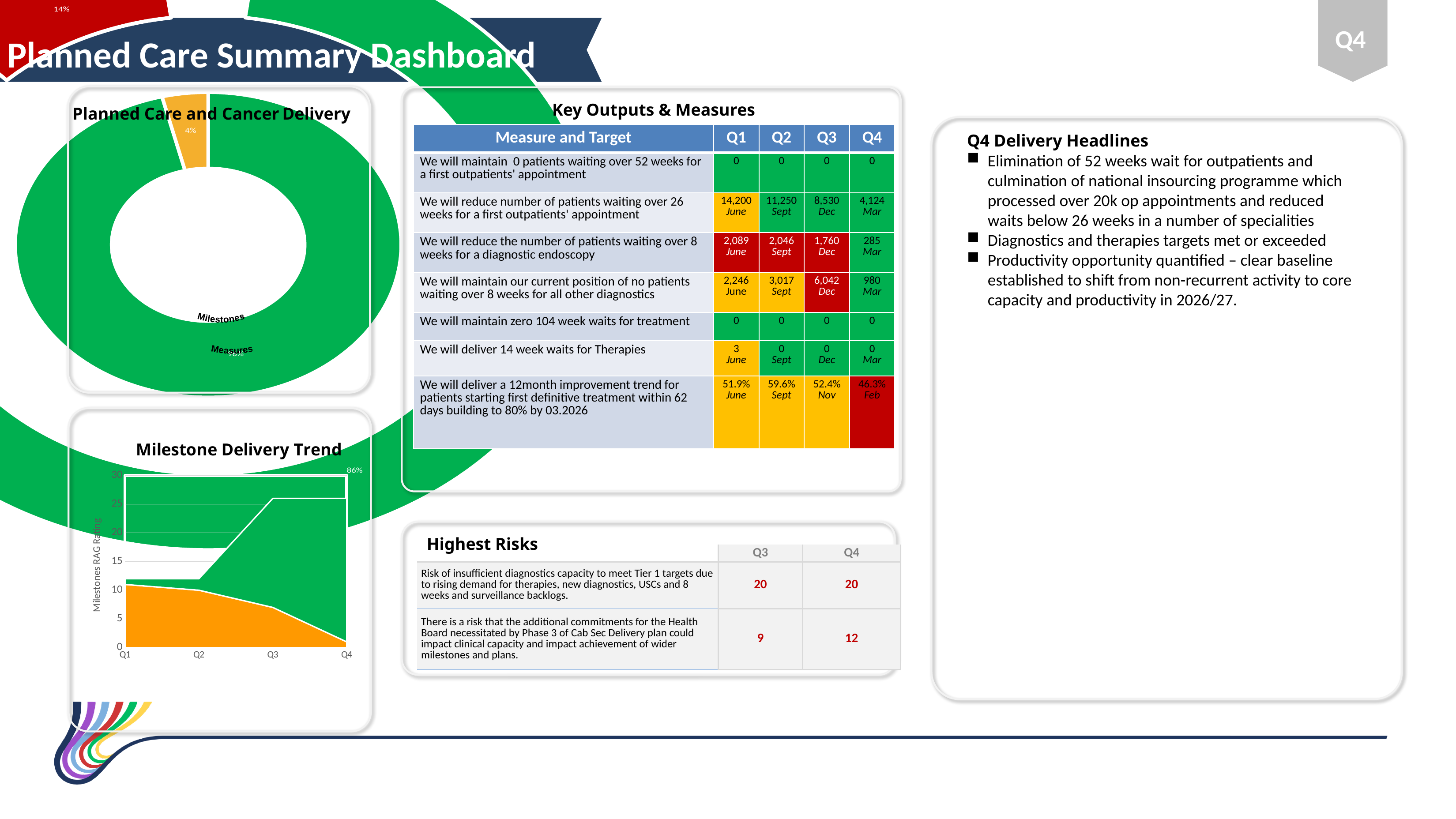
In the Milestone Delivery Trend chart, is the orange (amber) value at Q1 greater or less than 5? greater In the Milestone Delivery Trend chart, does the orange (amber) area rise or fall from Q1 to Q4? Fall In the Planned Care and Cancer Delivery doughnut chart, which slice is larger, the green slice or the amber slice? Green What is the title of the y axis on the Milestone Delivery Trend chart? Milestones RAG Rating In the Milestone Delivery Trend chart, does the top of the green area rise or fall from Q1 to Q4? Rise What kind of chart is the Milestone Delivery Trend chart? Area chart How many quarters are shown on the x axis of the Milestone Delivery Trend chart? 4 What kind of chart is the Planned Care and Cancer Delivery chart? Doughnut chart In the Milestone Delivery Trend chart, is the top of the stacked area at Q3 greater or less than 20? greater In the Milestone Delivery Trend chart, is the top of the stacked area at Q1 greater or less than 15? less In the Planned Care and Cancer Delivery doughnut chart, what percentage is labelled on the amber slice? 4%